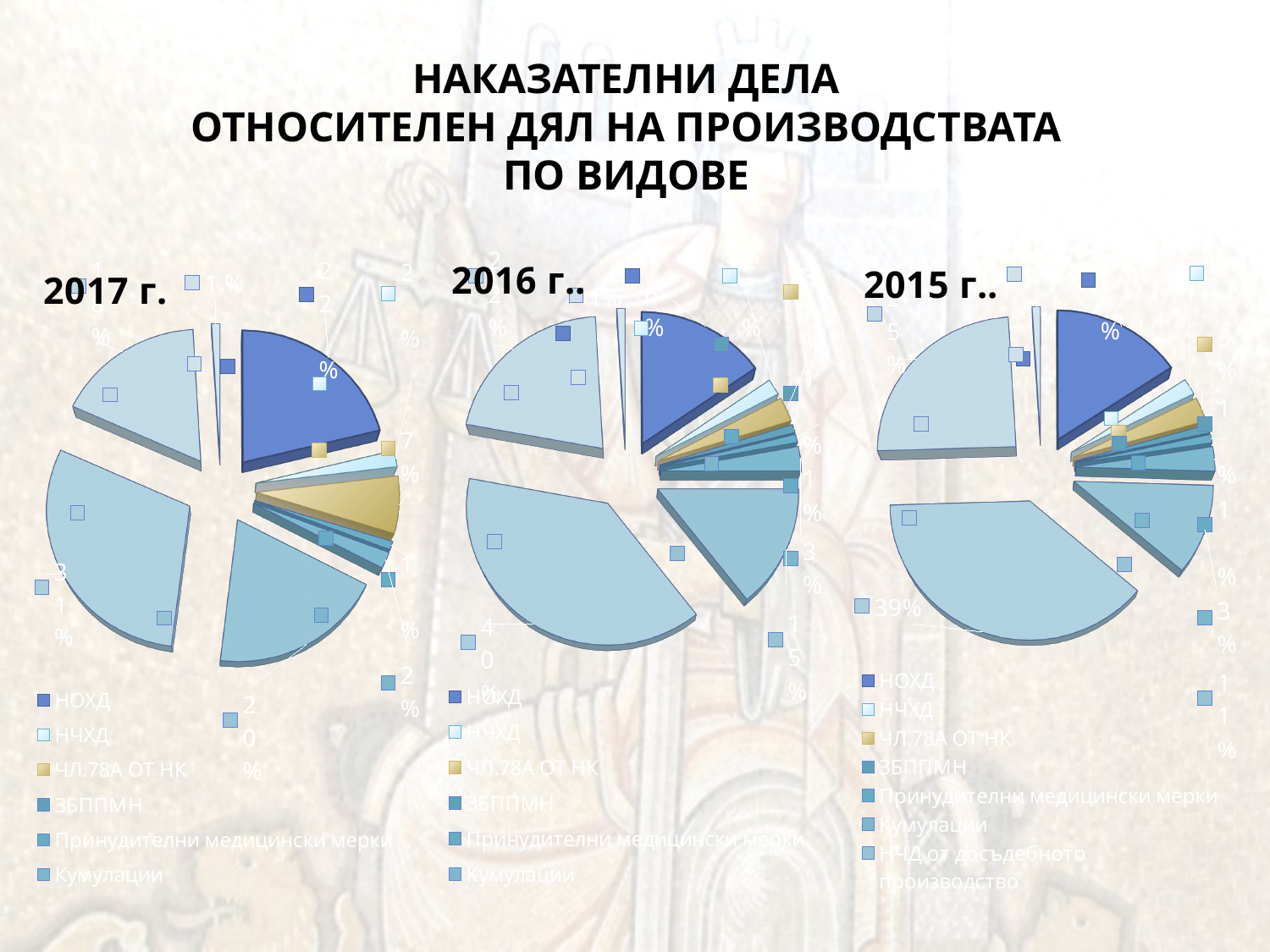
How many entries does the legend of the 2016 г. chart list? 6 How many pie charts are shown on the slide? 3 Which legend entry appears in the 2015 г. chart but not in the 2017 г. or 2016 г. charts? НЧД от досъдебното производство In the 2015 г. chart, what percentage label is printed on the largest slice? 39% What kind of chart is the 2015 г. chart? pie chart How many entries does the legend of the 2015 г. chart list? 7 What kind of chart is the 2017 г. chart? pie chart How many entries does the legend of the 2017 г. chart list? 6